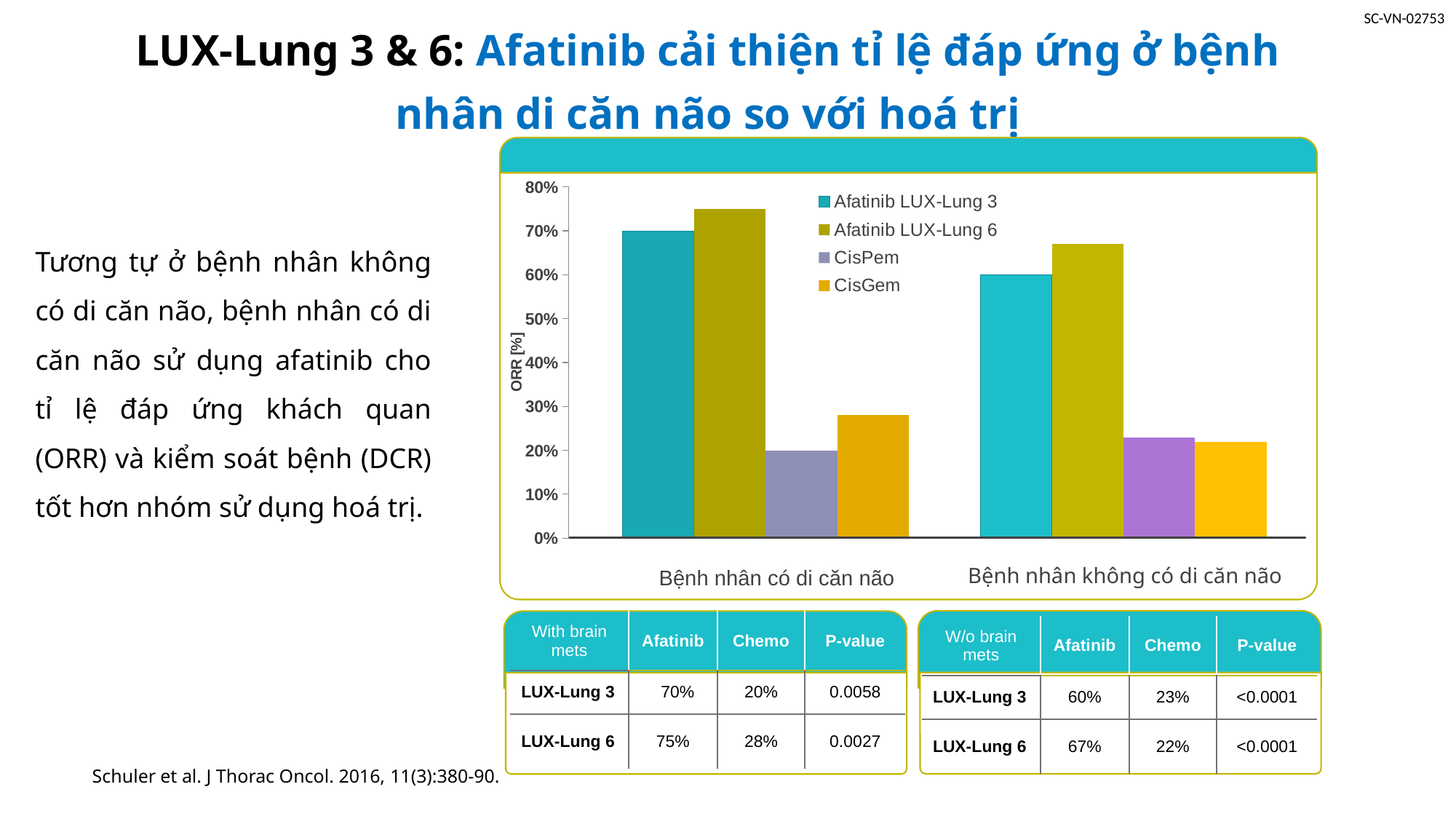
What is the label of the y axis of the chart? ORR [%] Which series has the highest ORR in the 'Bệnh nhân không có di căn não' group? Afatinib LUX-Lung 6 Is the ORR for CisGem in the 'Bệnh nhân có di căn não' group greater or less than 20%? greater Which series has the lowest ORR in the 'Bệnh nhân có di căn não' group? CisPem What is the ORR for Afatinib LUX-Lung 3 in the 'Bệnh nhân không có di căn não' group? 60% How many series does the chart legend list? 4 How many categories are shown on the x axis of the chart? 2 Which series has the highest ORR in the 'Bệnh nhân có di căn não' group? Afatinib LUX-Lung 6 What is the ORR for CisPem in the 'Bệnh nhân có di căn não' group? 20% Is the ORR for Afatinib LUX-Lung 3 higher in the 'Bệnh nhân có di căn não' group or the 'Bệnh nhân không có di căn não' group? Bệnh nhân có di căn não What kind of chart is shown on the slide? bar chart What is the ORR for Afatinib LUX-Lung 3 in the 'Bệnh nhân có di căn não' group? 70%